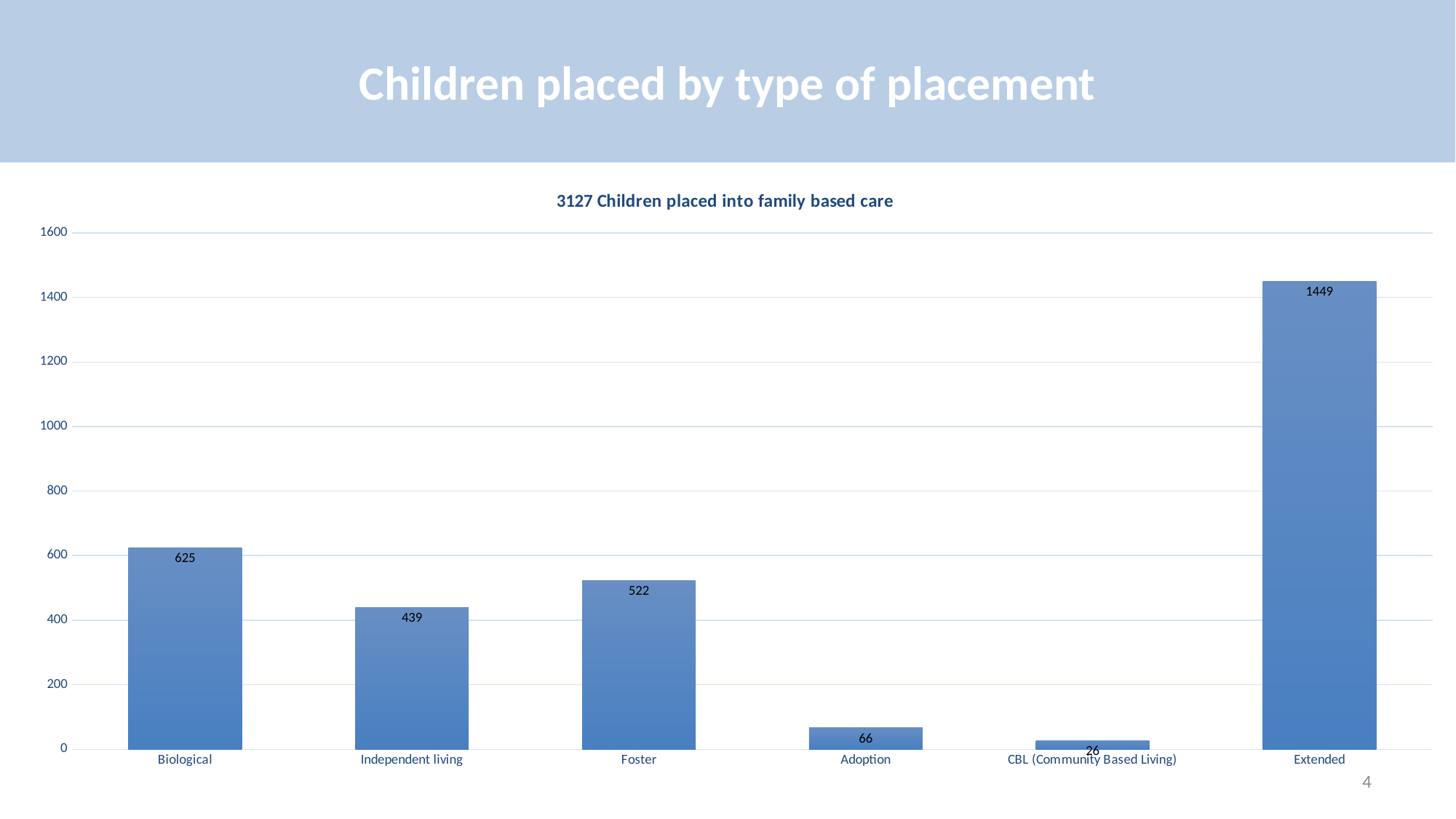
What is the difference between the values for Biological and Foster? 103 Which is larger, the value for Independent living or the value for Foster? Foster How many placement types are shown on the chart? 6 Is the value for Extended greater or less than 1400? greater Which placement type has the highest value? Extended What is the value for Extended? 1449 What is the value for CBL (Community Based Living)? 26 What is the difference between the values for Adoption and CBL (Community Based Living)? 40 What is the value for Biological? 625 Which placement type has the lowest value? CBL (Community Based Living) What is the title of the chart? 3127 Children placed into family based care What kind of chart is shown on the slide? bar chart